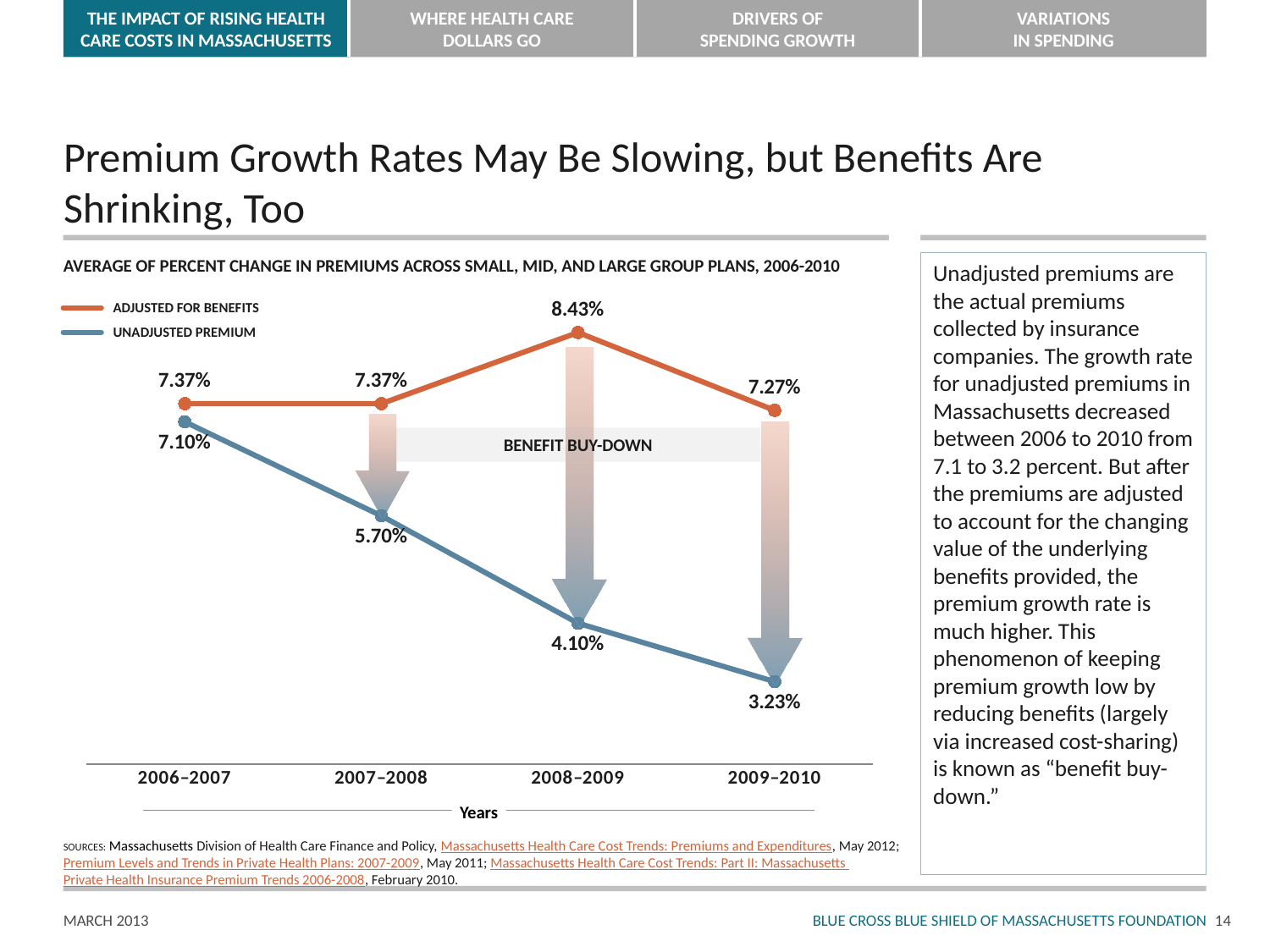
Which is larger in 2009–2010: the adjusted-for-benefits rate or the unadjusted premium rate? Adjusted for benefits Does the unadjusted premium growth rate rise or fall from 2006–2007 to 2009–2010? Fall What is the difference between the adjusted and unadjusted growth rates in 2006–2007? 0.27% What kind of chart is shown on the slide? Line chart What is the unadjusted premium growth rate for 2007–2008? 5.70% In which period is the unadjusted premium growth rate lowest? 2009–2010 What is the adjusted-for-benefits premium growth rate for 2008–2009? 8.43% How many time periods are shown on the x axis? 4 How many series does the legend list? 2 In which period is the adjusted-for-benefits growth rate highest? 2008–2009 What is the difference between the adjusted and unadjusted growth rates in 2008–2009? 4.33% What is the unadjusted premium growth rate for 2009–2010? 3.23%